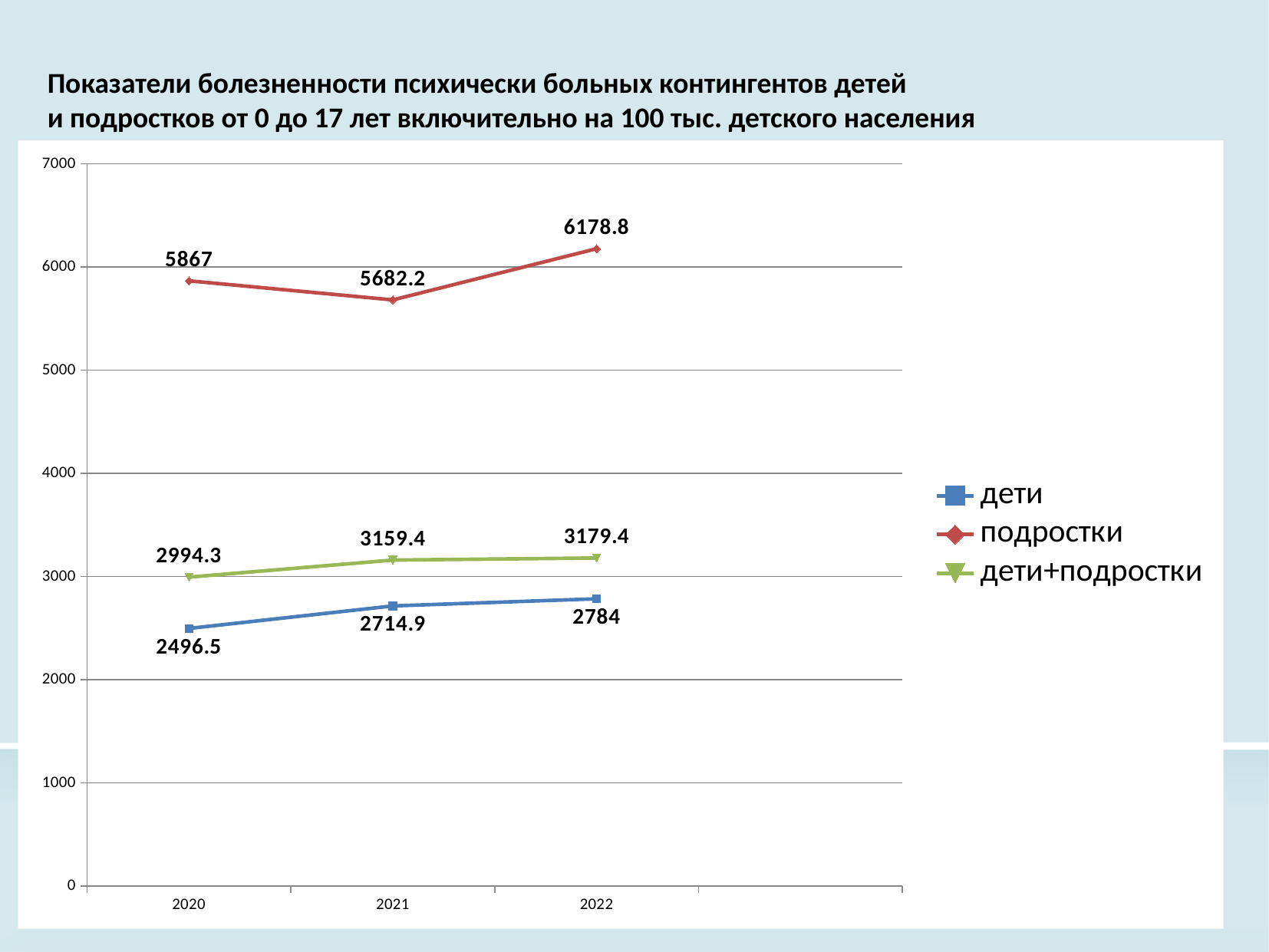
How many years are shown on the x axis? 3 What is the value for подростки in 2022? 6178.8 In which year is the value for подростки lowest? 2021 Is the value for дети in 2022 greater or less than 3000? less In which year is the value for дети highest? 2022 What is the difference between the дети values in 2021 and 2020? 218.4 What is the value for дети in 2020? 2496.5 What kind of chart is shown on the slide? line chart What is the value for дети+подростки in 2021? 3159.4 How many series does the legend list? 3 Which is larger in 2020: the value for подростки or the value for дети+подростки? подростки What is the difference between the подростки values in 2022 and 2021? 496.6